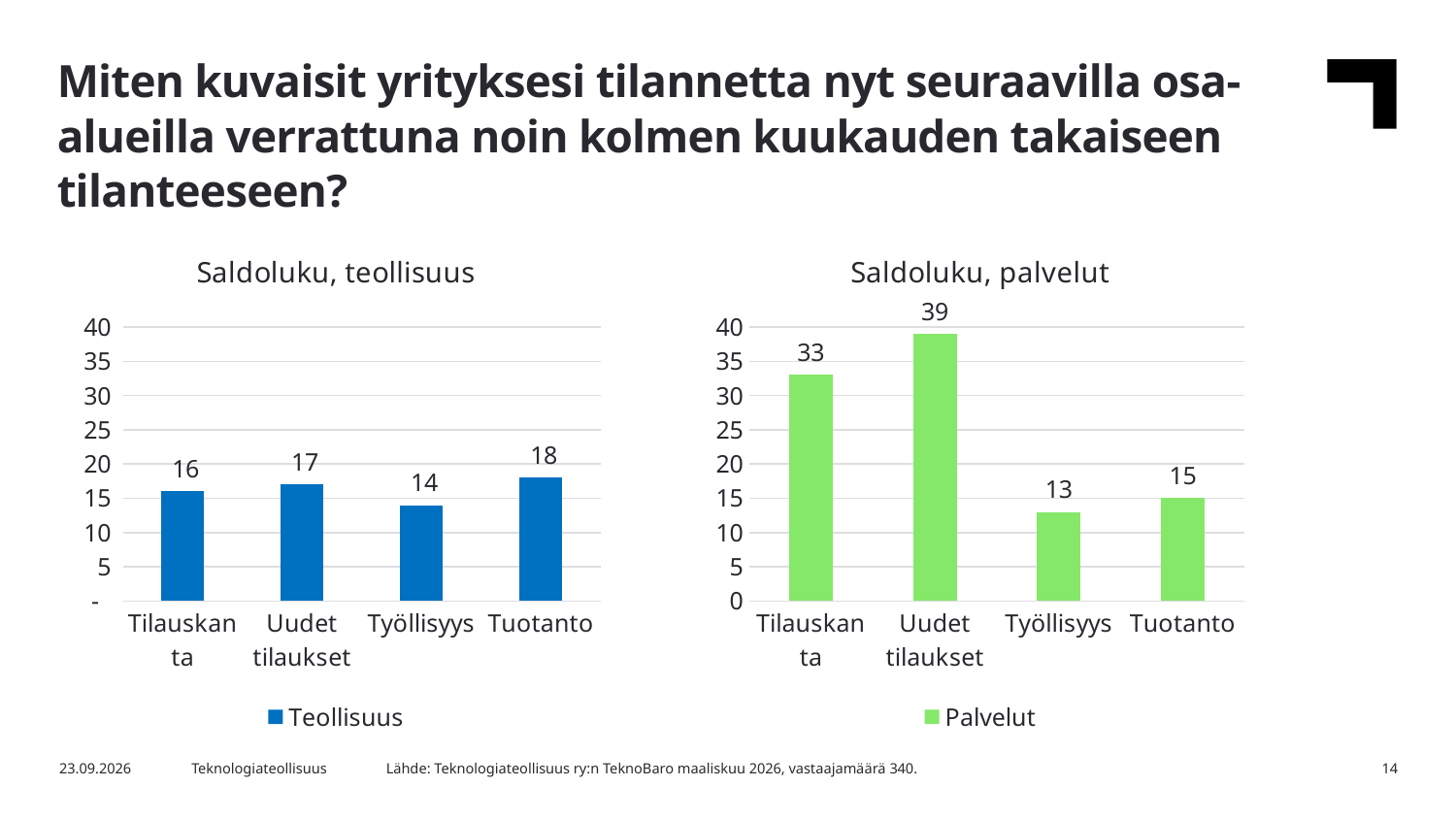
What is the legend entry of the chart on the right? Palvelut In the 'Saldoluku, palvelut' chart, what is the difference between Uudet tilaukset and Työllisyys? 26 What kind of chart is the 'Saldoluku, palvelut' chart? Bar chart In the 'Saldoluku, teollisuus' chart, what is the difference between Tuotanto and Työllisyys? 4 In the 'Saldoluku, teollisuus' chart, which category has the lowest value? Työllisyys In the 'Saldoluku, teollisuus' chart, what is the value for Tuotanto? 18 How many series does the legend of the 'Saldoluku, teollisuus' chart list? 1 In the 'Saldoluku, palvelut' chart, is the value for Tilauskanta greater or less than 30? greater In the 'Saldoluku, palvelut' chart, which category has the highest value? Uudet tilaukset In the 'Saldoluku, teollisuus' chart, which is larger: Tilauskanta or Uudet tilaukset? Uudet tilaukset In the 'Saldoluku, palvelut' chart, what is the value for Uudet tilaukset? 39 How many categories are shown in the 'Saldoluku, palvelut' chart? 4